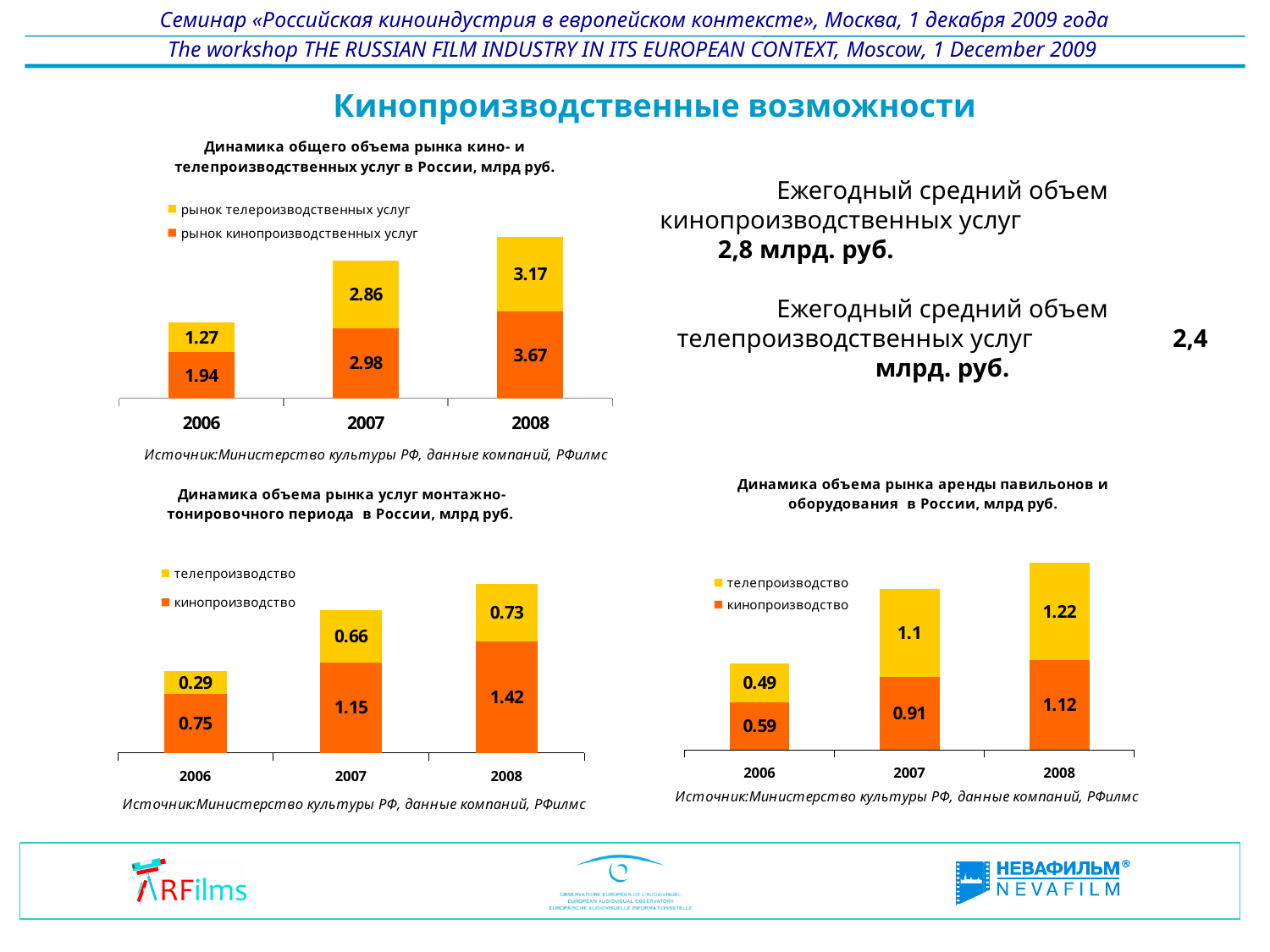
In the bottom-left chart (Динамика объема рынка услуг монтажно-тонировочного периода), do the values for кинопроизводство rise or fall from 2006 to 2008? rise In the bottom-right chart (Динамика объема рынка аренды павильонов и оборудования), what is the value for телепроизводство in 2007? 1.1 In the bottom-left chart (Динамика объема рынка услуг монтажно-тонировочного периода), what is the difference between телепроизводство in 2007 and in 2006? 0.37 In the top-left chart (Динамика общего объема рынка кино- и телепроизводственных услуг), what is the value for рынок кинопроизводственных услуг in 2007? 2.98 In the top-left chart (Динамика общего объема рынка кино- и телепроизводственных услуг), which year has the highest value for рынок кинопроизводственных услуг? 2008 In the bottom-right chart (Динамика объема рынка аренды павильонов и оборудования), what is the total of the stacked bar for 2006? 1.08 In the top-left chart (Динамика общего объема рынка кино- и телепроизводственных услуг), what is the value for рынок телепроизводственных услуг in 2006? 1.27 How many series does the legend of the bottom-right chart (Динамика объема рынка аренды павильонов и оборудования) list? 2 In the bottom-left chart (Динамика объема рынка услуг монтажно-тонировочного периода), what is the total of the stacked bar for 2007? 1.81 In the bottom-left chart (Динамика объема рынка услуг монтажно-тонировочного периода), what is the value for кинопроизводство in 2008? 1.42 In the bottom-right chart (Динамика объема рынка аренды павильонов и оборудования), which is larger in 2008: кинопроизводство or телепроизводство? телепроизводство In the top-left chart (Динамика общего объема рынка кино- и телепроизводственных услуг), what is the total of the stacked bar for 2008? 6.84